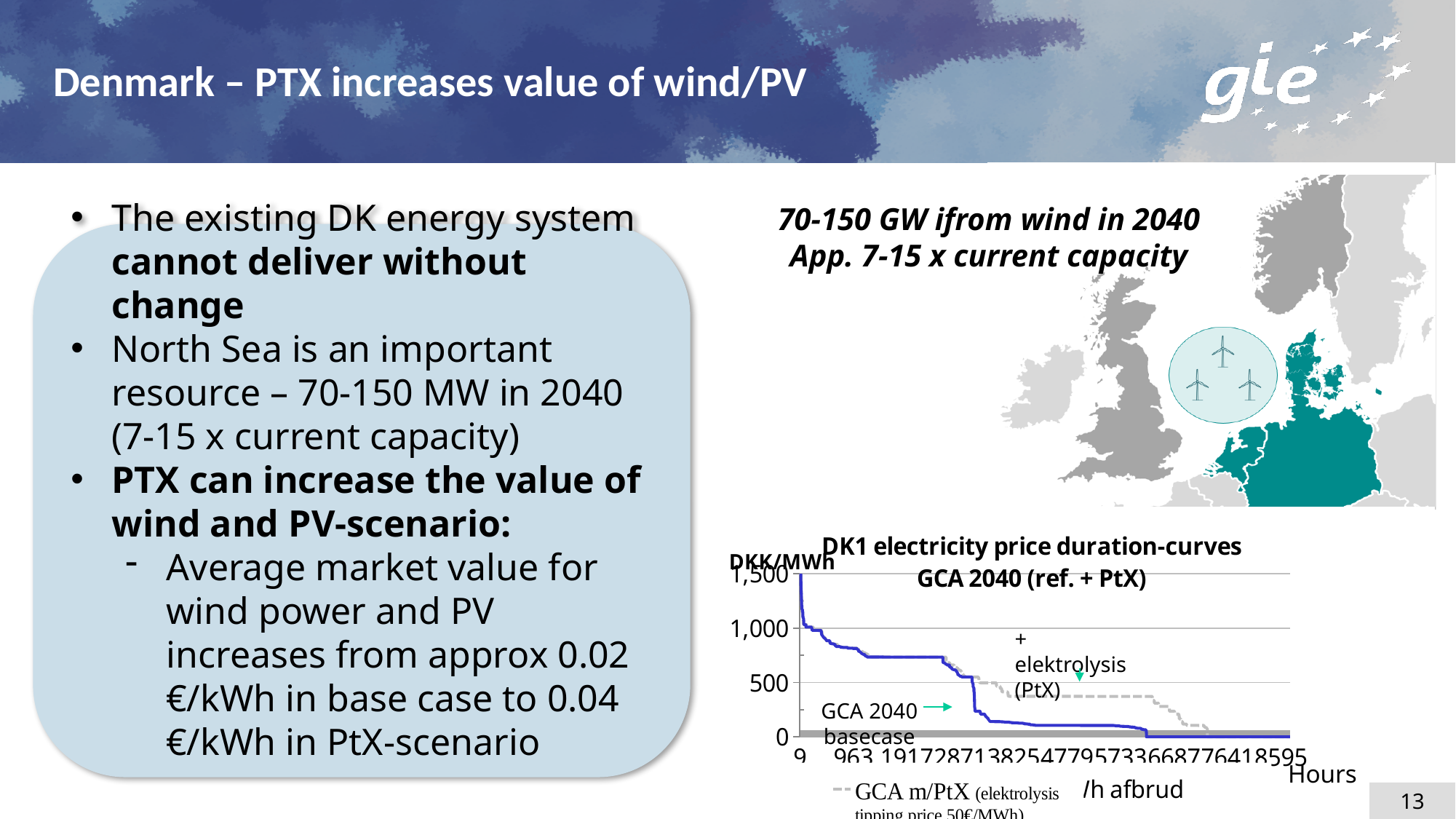
What is the highest tick value shown on the vertical axis of the chart? 1,500 What is the last tick label on the Hours axis of the chart? 8595 At hour 5733, which series has the higher price: GCA 2040 basecase or GCA m/PtX? GCA m/PtX What unit is shown on the vertical axis of the chart? DKK/MWh Is the GCA 2040 basecase value at hour 5733 greater or less than 500? less What is the title of the chart on the slide? DK1 electricity price duration-curves GCA 2040 (ref. + PtX) Does the GCA 2040 basecase curve rise or fall as hours increase along the x axis? fall Is the GCA m/PtX value at hour 5733 greater or less than 500? less How many series are plotted in the chart? 2 What kind of chart is shown on the slide? line chart How many tick labels are shown on the Hours axis of the chart? 10